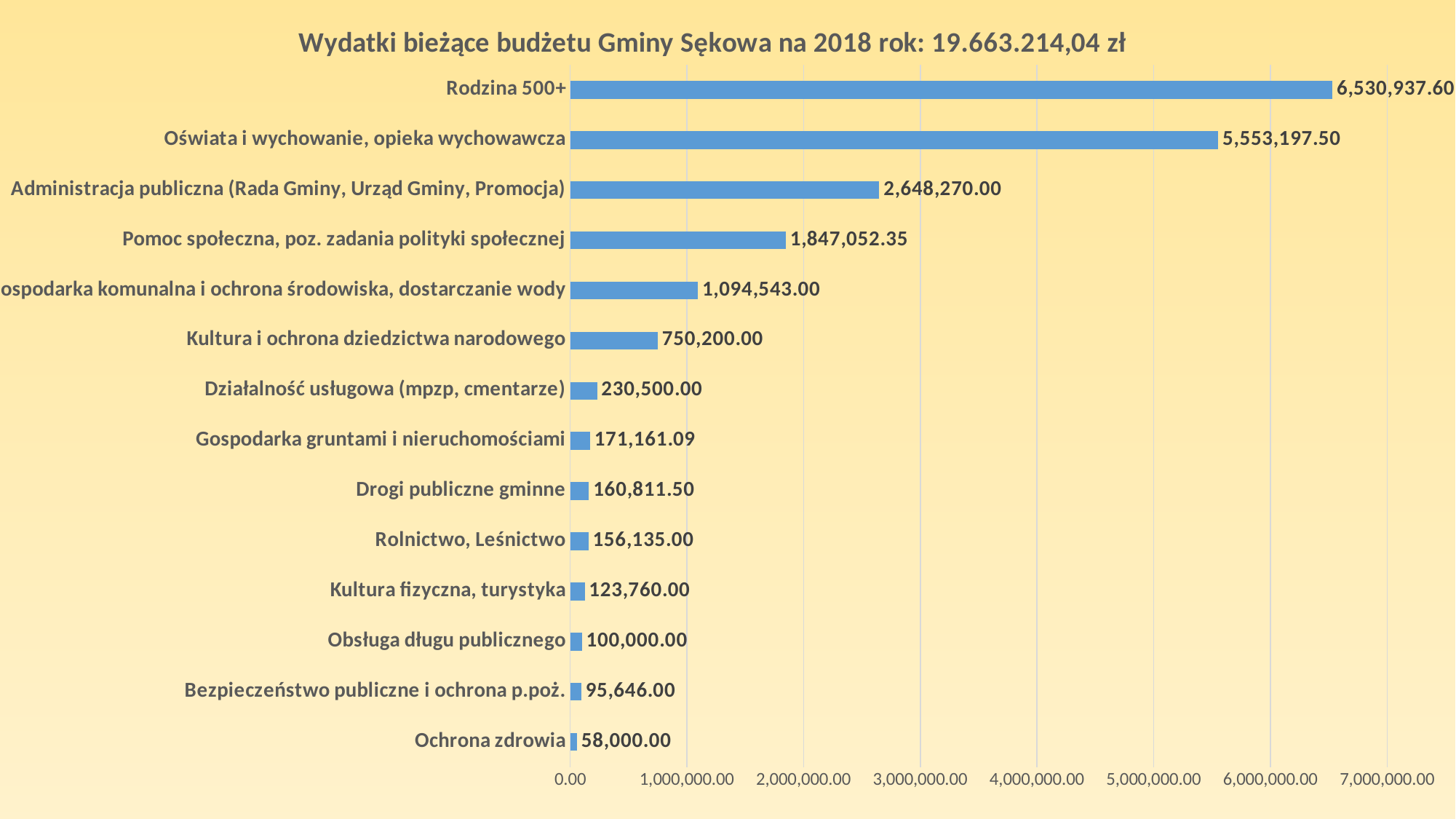
Which category has the lowest value? Ochrona zdrowia What kind of chart is shown on the slide? bar chart Is the value for Oświata i wychowanie, opieka wychowawcza greater or less than 5,000,000.00? greater What is the value for Rodzina 500+? 6,530,937.60 How many categories are shown in the chart? 14 Which category has the highest value? Rodzina 500+ What is the value for Kultura i ochrona dziedzictwa narodowego? 750,200.00 Which is larger, the value for Administracja publiczna (Rada Gminy, Urząd Gminy, Promocja) or the value for Pomoc społeczna, poz. zadania polityki społecznej? Administracja publiczna (Rada Gminy, Urząd Gminy, Promocja) What is the difference between the values for Działalność usługowa (mpzp, cmentarze) and Gospodarka gruntami i nieruchomościami? 59,338.91 What is the value for Obsługa długu publicznego? 100,000.00 What is the difference between the values for Rodzina 500+ and Oświata i wychowanie, opieka wychowawcza? 977,740.10 What is the title of the chart? Wydatki bieżące budżetu Gminy Sękowa na 2018 rok: 19.663.214,04 zł